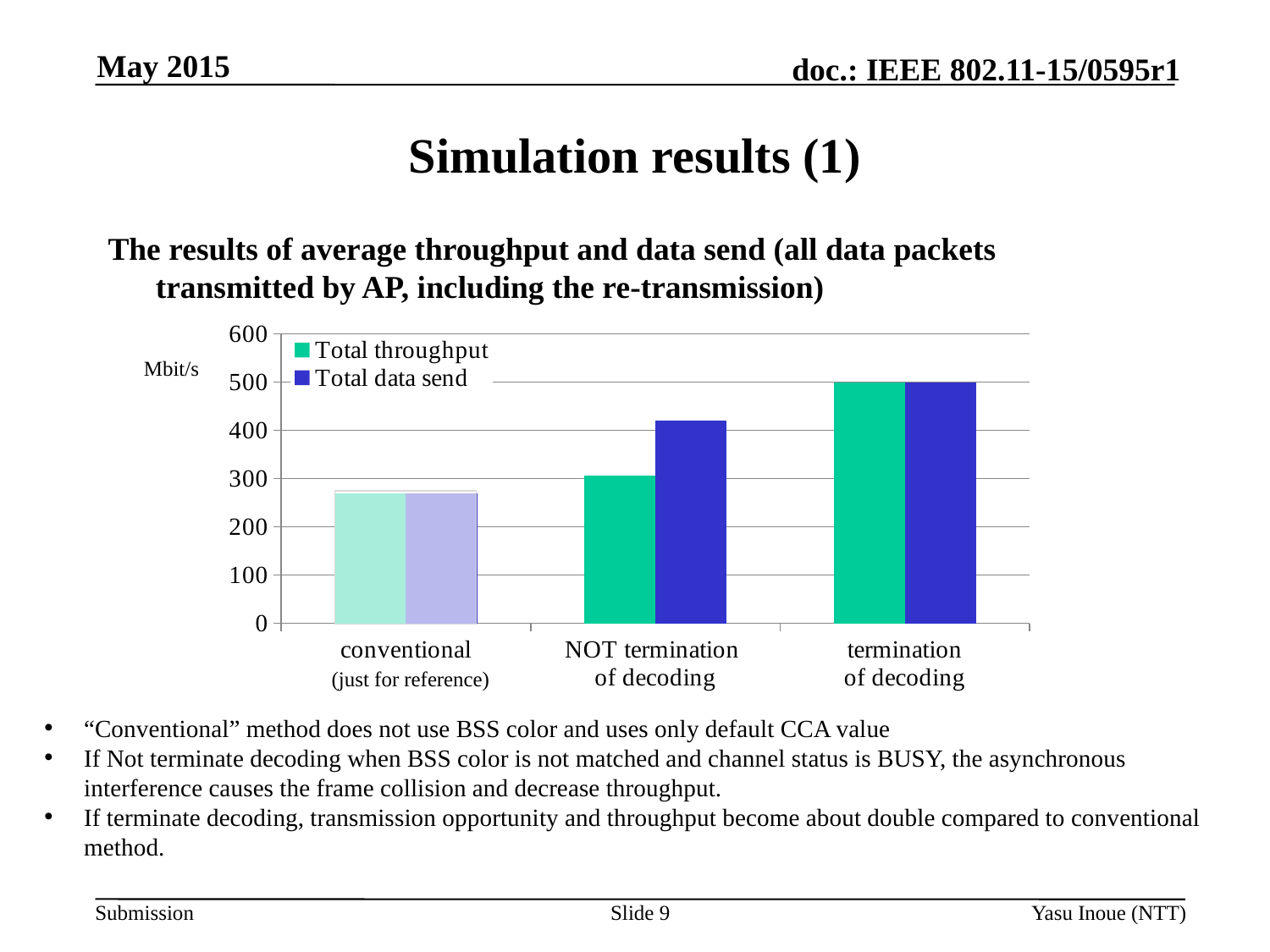
How many categories are shown on the x axis of the chart? 3 Is the Total data send value for NOT termination of decoding greater or less than 400? greater How many series does the chart legend list? 2 Do the Total data send values rise or fall from left to right across the categories? rise Is the Total throughput value for conventional greater or less than 300? less What kind of chart is shown on the slide? bar chart Which category has the highest Total data send value? termination of decoding What unit is shown on the y axis of the chart? Mbit/s What are the two series named in the chart legend? Total throughput and Total data send For NOT termination of decoding, which is larger: Total throughput or Total data send? Total data send Which category has the lowest Total throughput value? conventional Is the Total throughput value for termination of decoding greater or less than 400? greater